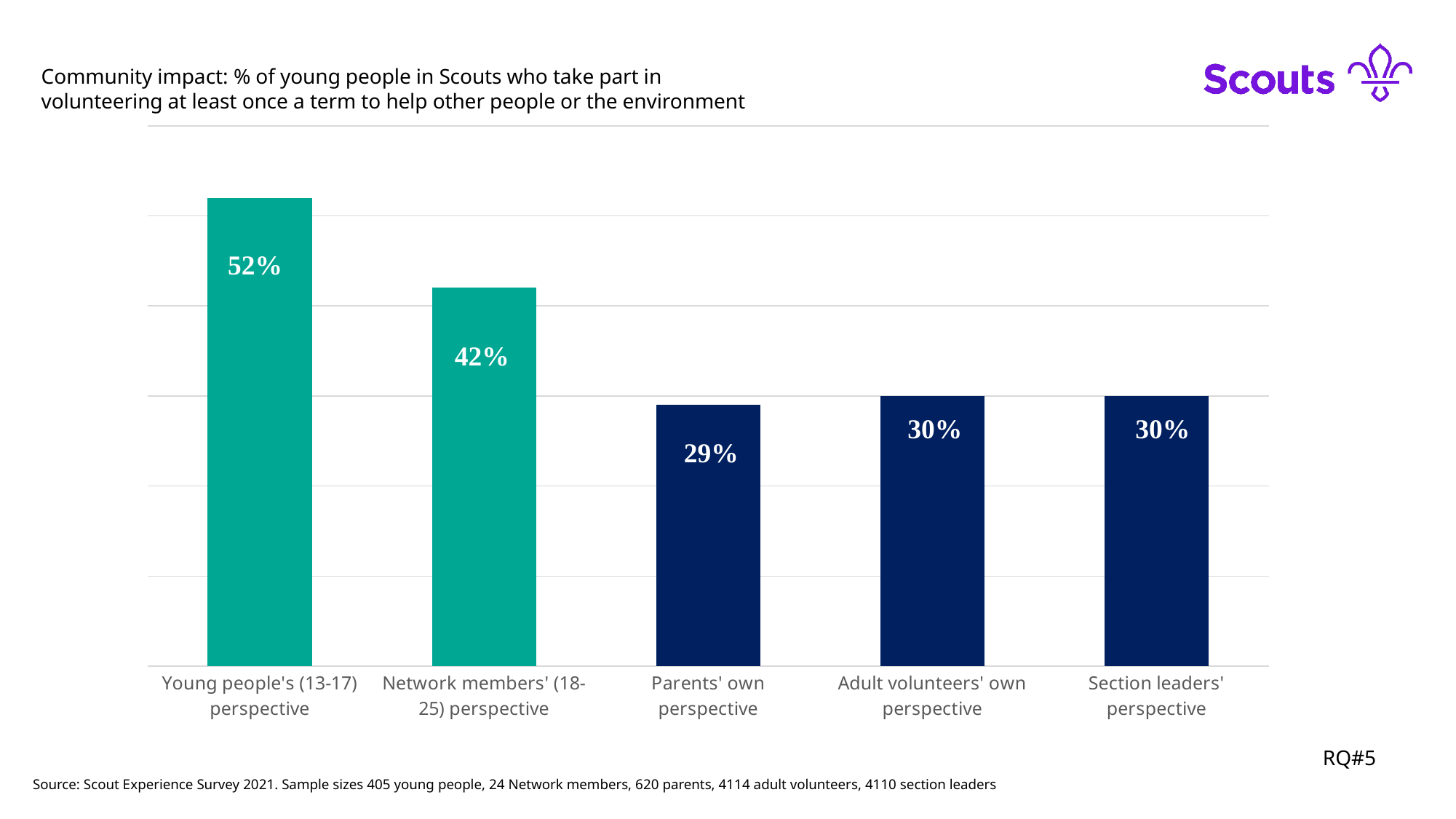
What is the value for Young people's (13-17) perspective? 52% What is the difference between the values for Young people's (13-17) perspective and Network members' (18-25) perspective? 10% What is the value for Section leaders' perspective? 30% What kind of chart is shown on the slide? Bar chart Which category has the lowest value? Parents' own perspective Which is larger, the value for Network members' (18-25) perspective or the value for Section leaders' perspective? Network members' (18-25) perspective What is the difference between the values for Network members' (18-25) perspective and Adult volunteers' own perspective? 12% What is the value for Network members' (18-25) perspective? 42% How many categories are shown in the chart? 5 What is the source cited below the chart? Scout Experience Survey 2021 Which category has the highest value? Young people's (13-17) perspective What is the value for Parents' own perspective? 29%